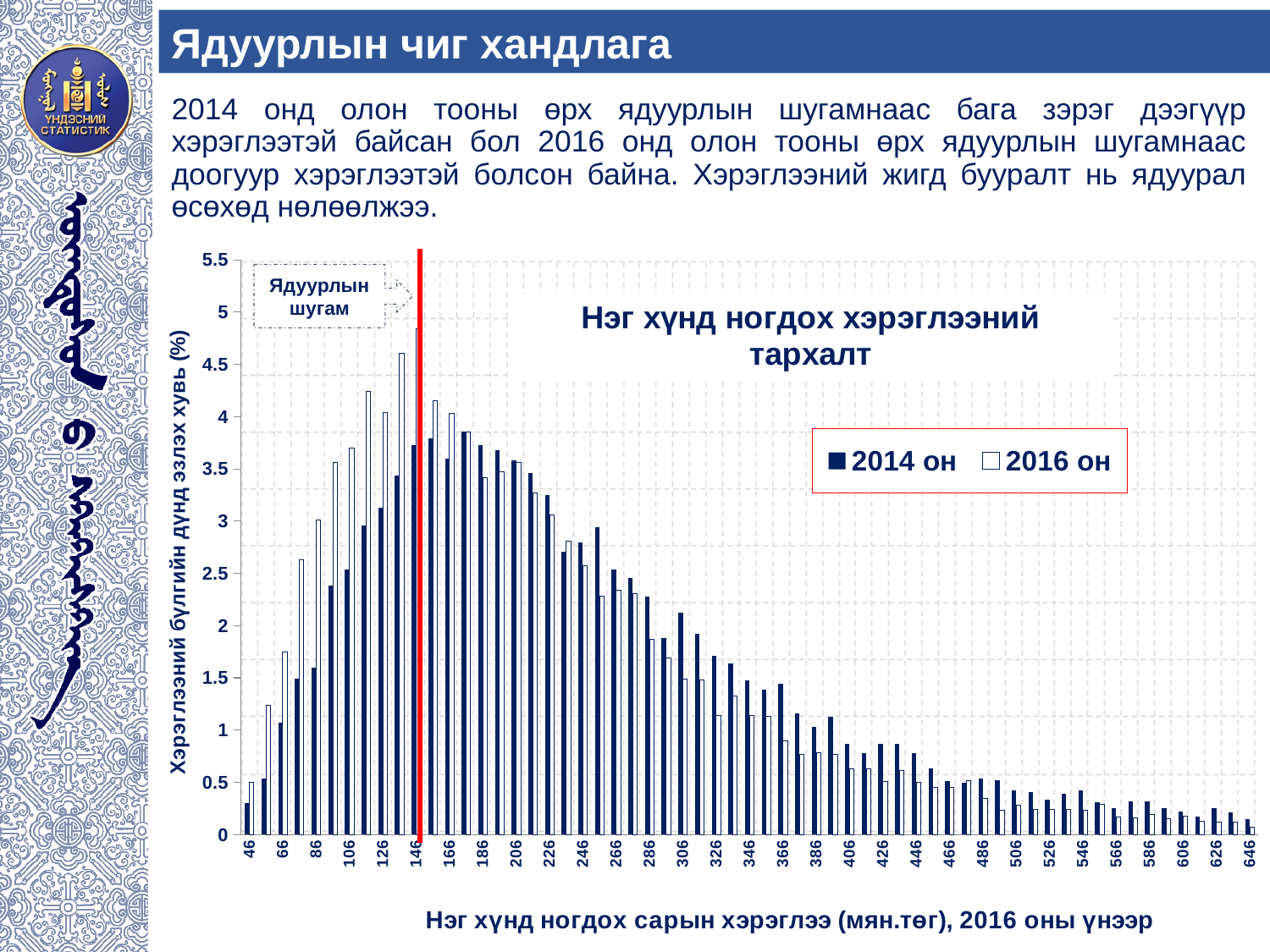
Is the highest value of the 2016 он series greater or less than 4.5? greater From the category 346 to 646, do the 2014 он values generally rise or fall? fall How many series does the chart legend list? 2 What is the title of the chart? Нэг хүнд ногдох хэрэглээний тархалт Is the value for 2016 он at the category 406 greater or less than 1? less At the category 306, which series has the larger value, 2014 он or 2016 он? 2014 он Is the highest value of the 2014 он series greater or less than 4? less Which series reaches the higher peak value, 2014 он or 2016 он? 2016 он What kind of chart is shown on the slide? Bar chart At the category 86, which series has the larger value, 2014 он or 2016 он? 2016 он What are the two series named in the chart legend? 2014 он and 2016 он